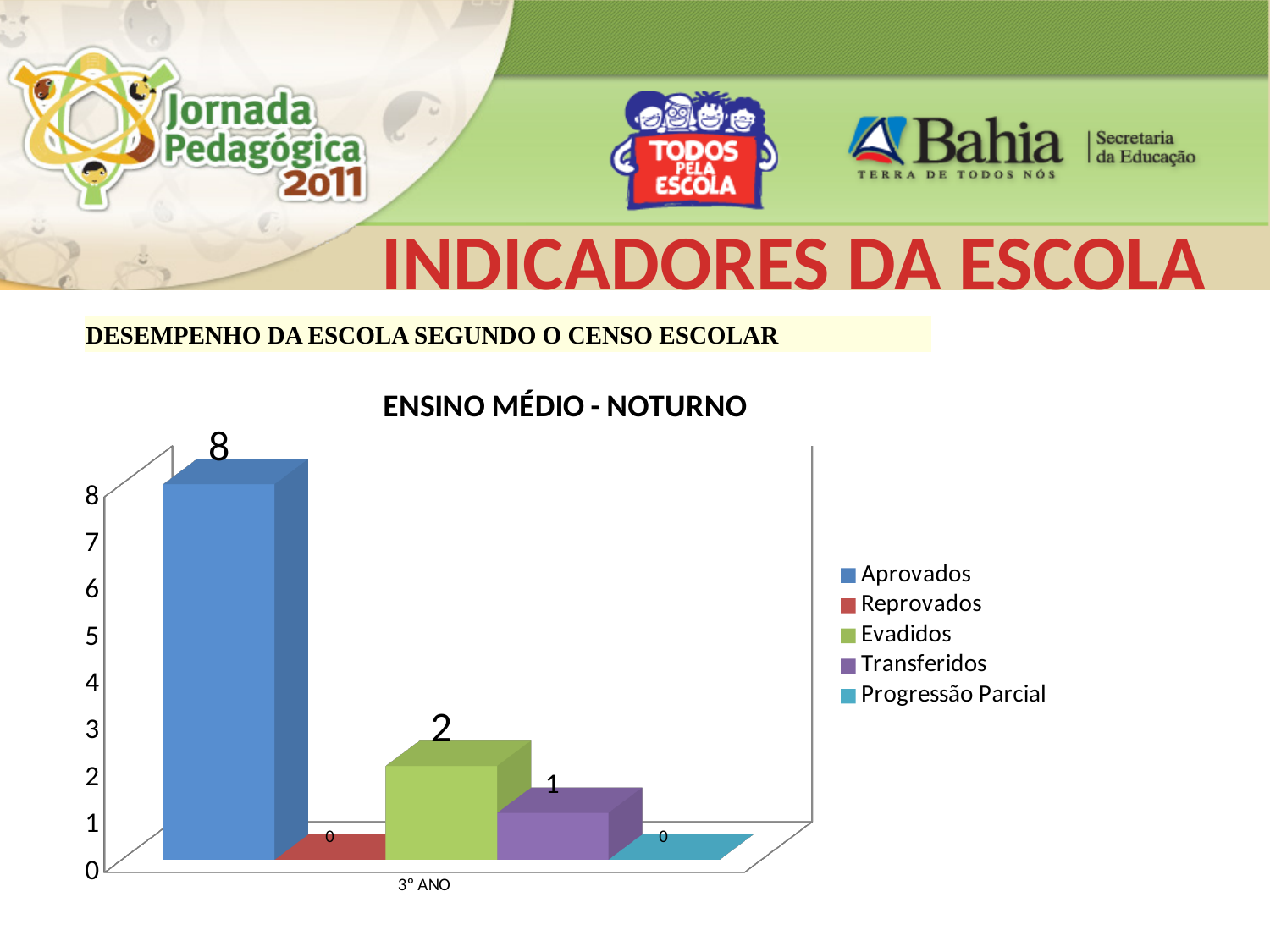
Is the value for Aprovados greater or less than 5? greater Which series has the highest value? Aprovados What is the difference between the Aprovados and Evadidos values? 6 What is the value for Aprovados in the 3° ANO category? 8 What is the title of the chart? ENSINO MÉDIO - NOTURNO How many series does the legend list? 5 What kind of chart is shown? bar chart What is the value for Transferidos? 1 What is the value for Progressão Parcial? 0 Which is larger, Evadidos or Transferidos? Evadidos What is the value for Reprovados? 0 What is the value for Evadidos? 2